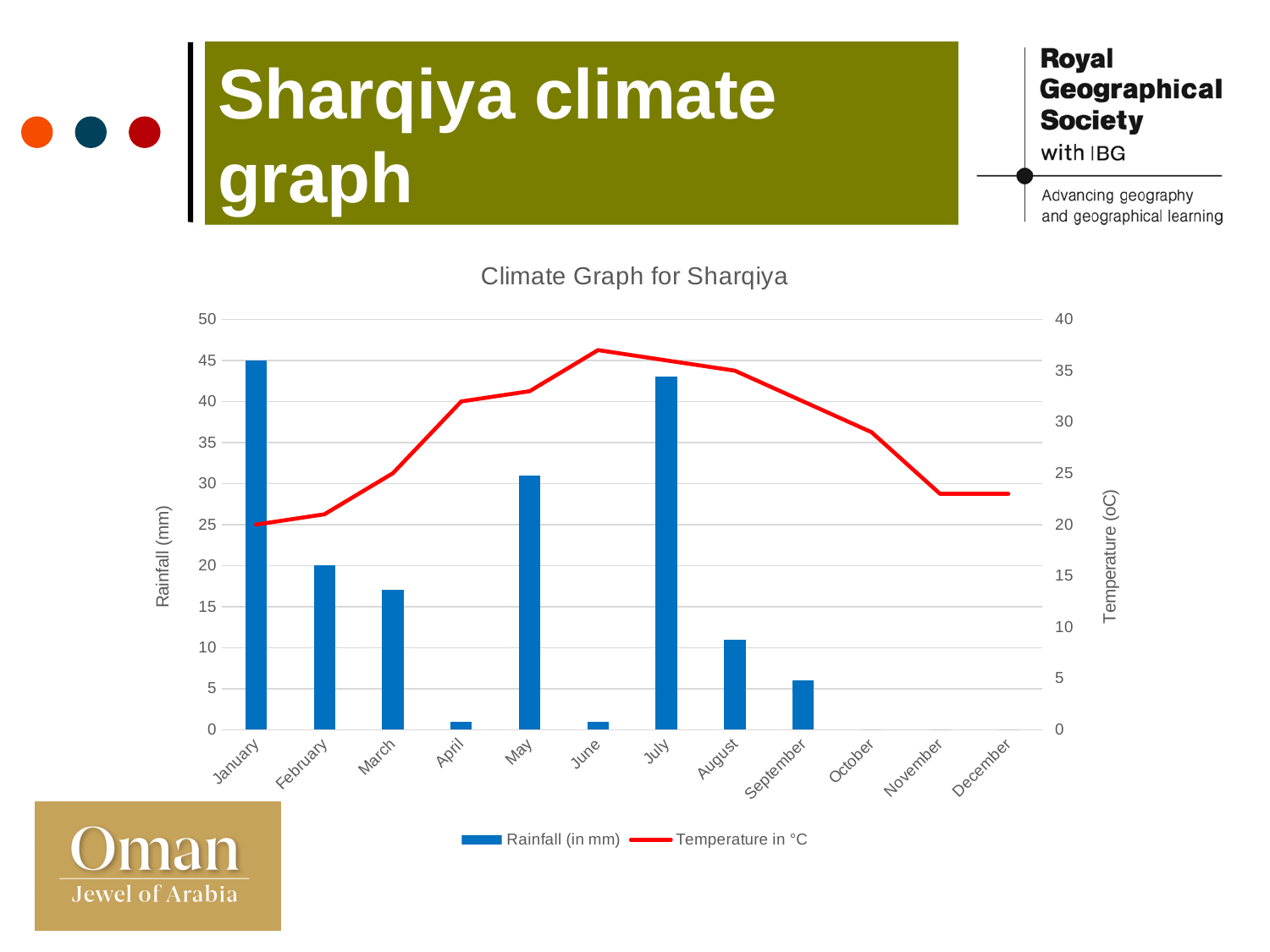
How many series does the legend list? 2 What is the rainfall in January? 45 What kind of chart is used to show Rainfall (in mm)? bar chart What is the difference between the rainfall in January and the rainfall in February? 25 What is the title of the chart? Climate Graph for Sharqiya Which month has the lowest temperature? January Which month has the highest temperature? June What is the rainfall in February? 20 How many months are shown on the x axis? 12 Which month has the highest rainfall? January